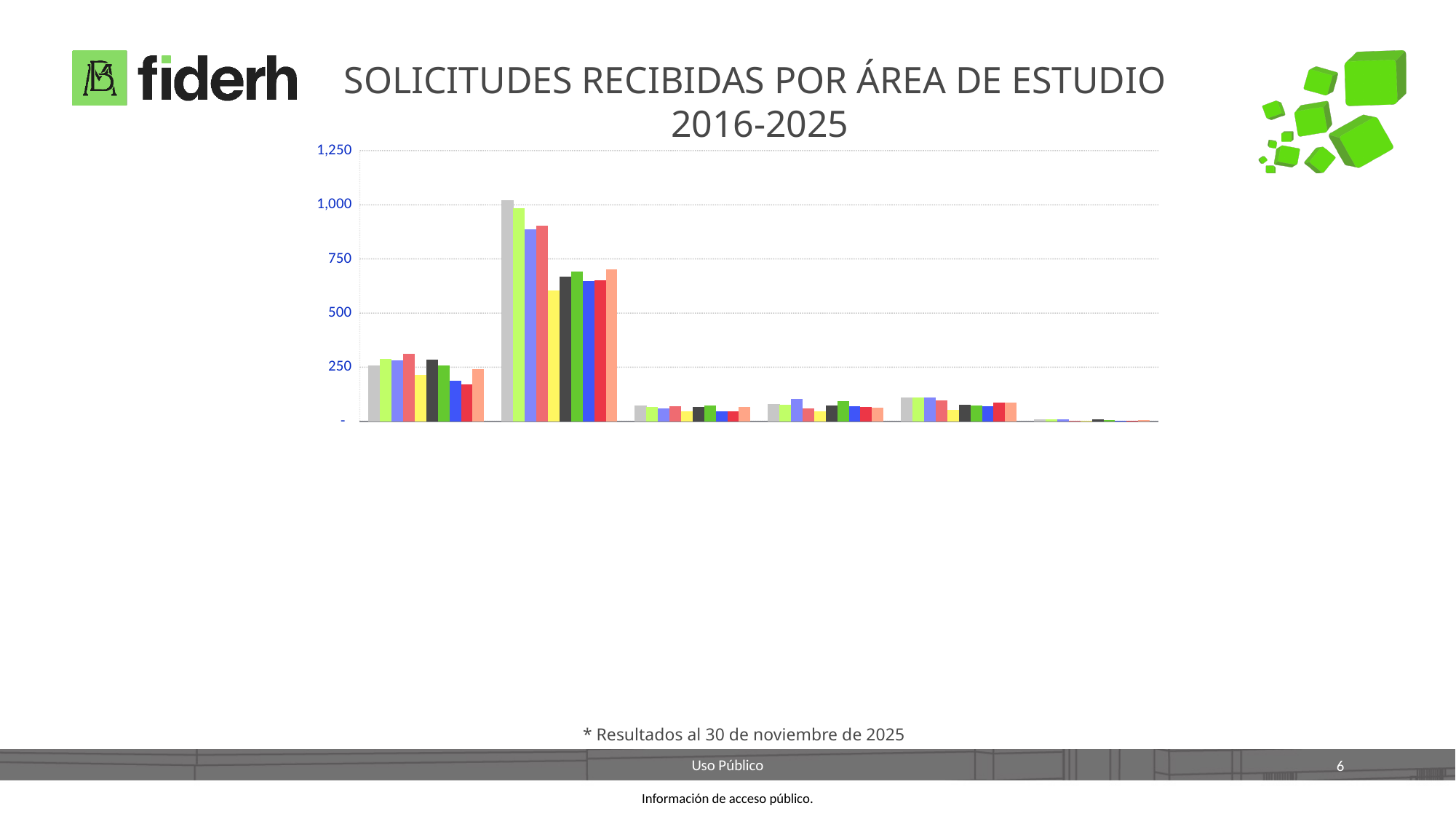
How many bars are there in each group of the chart? 10 Is the shortest bar in the second group from the left greater or less than 500? greater Is the tallest bar in the first group from the left greater or less than 250? greater What kind of chart is shown on the slide? bar chart What is the highest value shown on the vertical axis? 1,250 Is the tallest bar in the third group from the left greater or less than 250? less Are the bars in the first group from the left taller or shorter than the bars in the fifth group? taller How many groups of bars (categories) are plotted along the x axis? 6 Which group of bars, counting from the left, has the tallest bars? the second group What is the title of the chart on the slide? SOLICITUDES RECIBIDAS POR ÁREA DE ESTUDIO 2016-2025 Which group of bars, counting from the left, has the shortest bars? the sixth (last) group